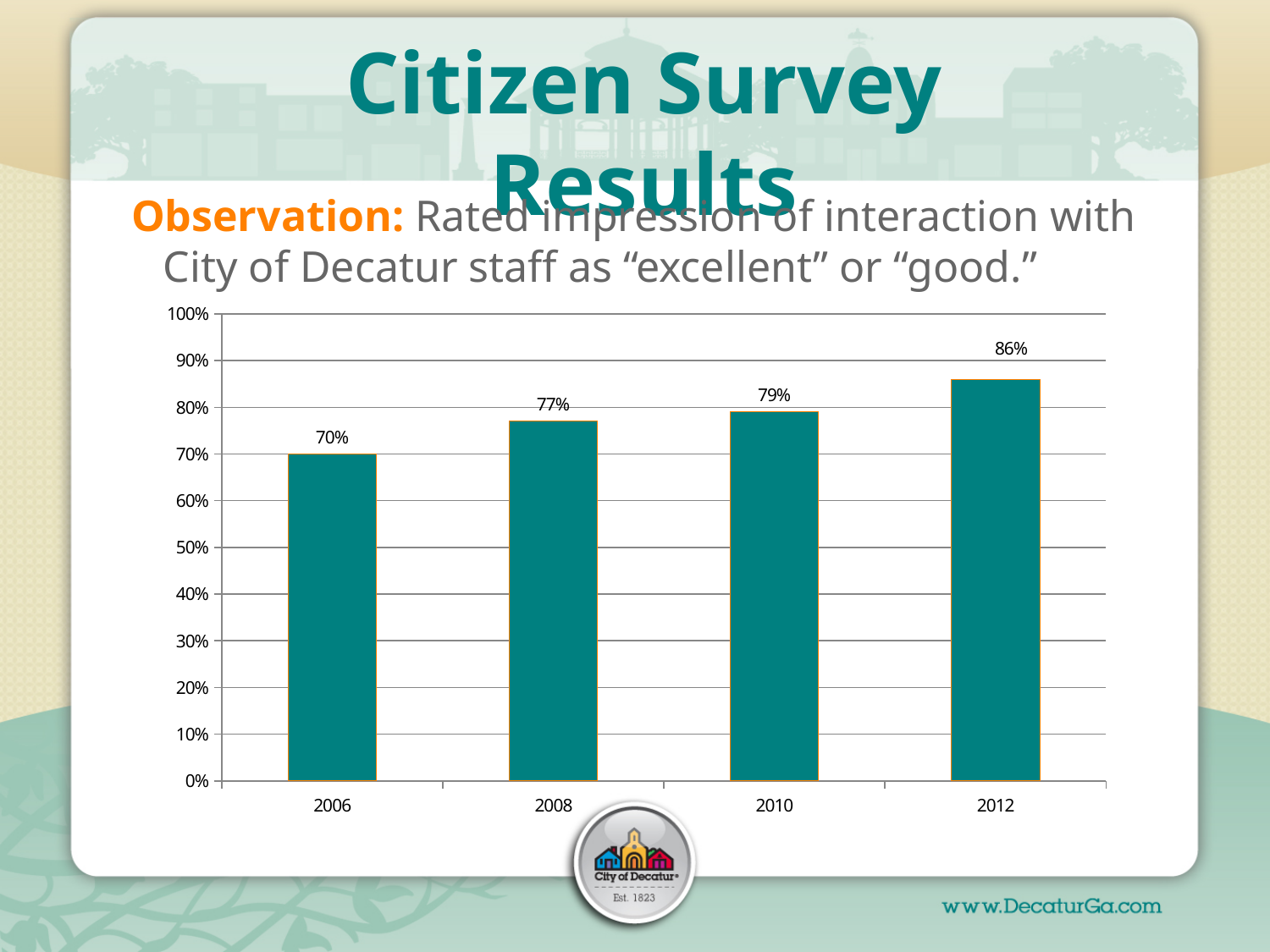
What is the difference between the 2012 value and the 2006 value? 16% What is the value shown for 2010? 79% Is the value for 2008 greater or less than 80%? less What kind of chart is shown on the slide? Bar chart Which year has the larger value, 2008 or 2012? 2012 What is the value shown for 2012? 86% Which year has the lowest value? 2006 Which year has the highest value? 2012 Do the values rise or fall from 2006 to 2012? Rise How many years are shown on the x axis? 4 What is the difference between the 2010 value and the 2008 value? 2% What percentage of respondents rated their impression of interaction with City of Decatur staff as excellent or good in 2006? 70%